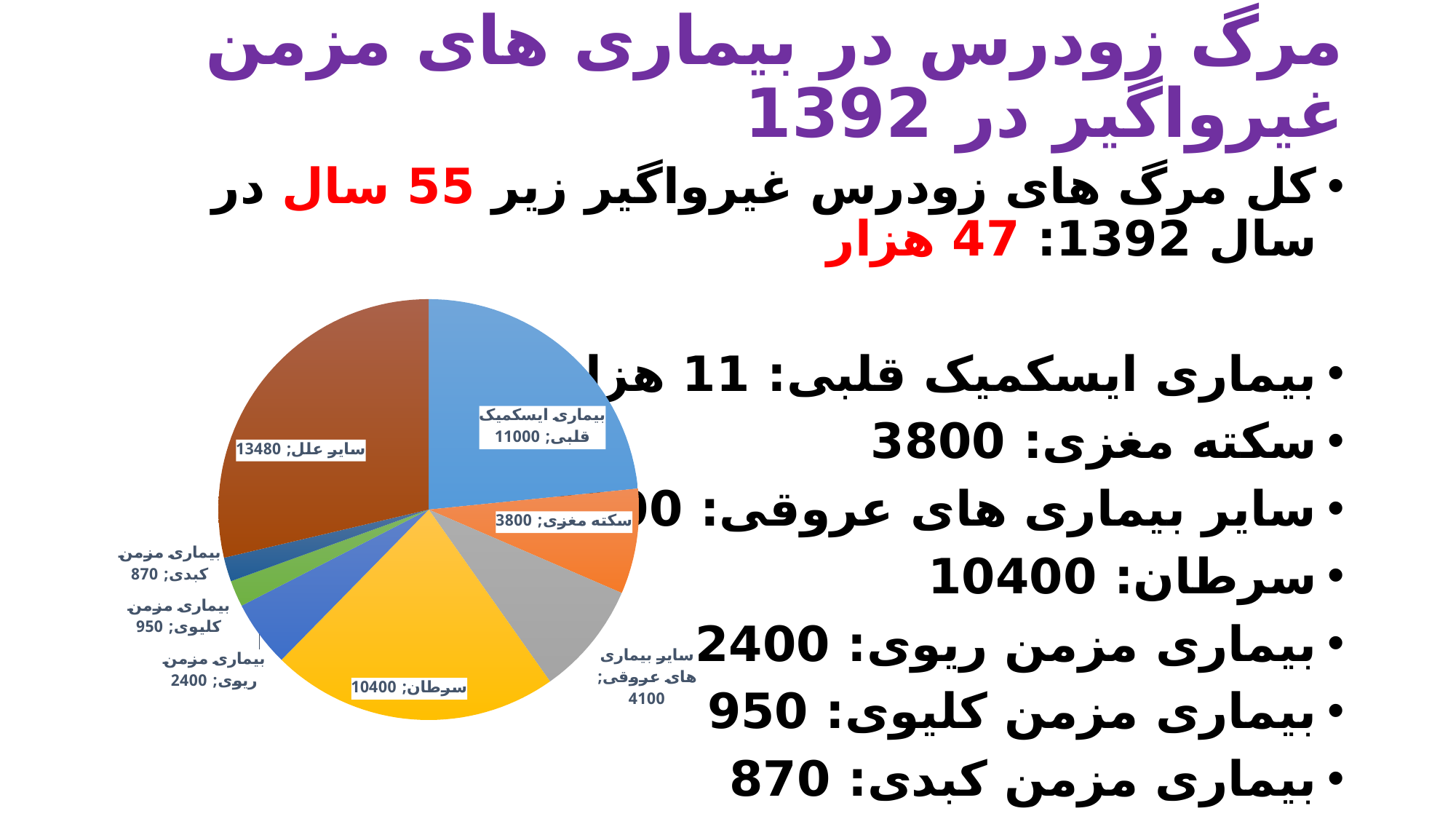
What colour is the سرطان slice in the pie chart? yellow What type of chart is shown on the slide? pie chart What is the value for بیماری مزمن کبدی in the pie chart? 870 What is the value for سکته مغزی in the pie chart? 3800 What is the value for سایر بیماری های عروقی in the pie chart? 4100 Which slice of the pie chart is the smallest? بیماری مزمن کبدی What is the difference between the values for بیماری ایسکمیک قلبی and سرطان? 600 Which is larger in the pie chart, سکته مغزی or سایر بیماری های عروقی? سایر بیماری های عروقی How many slices does the pie chart have? 8 Which slice of the pie chart is the largest? سایر علل What is the value for سرطان in the pie chart? 10400 What is the total of all slices in the pie chart? 47000